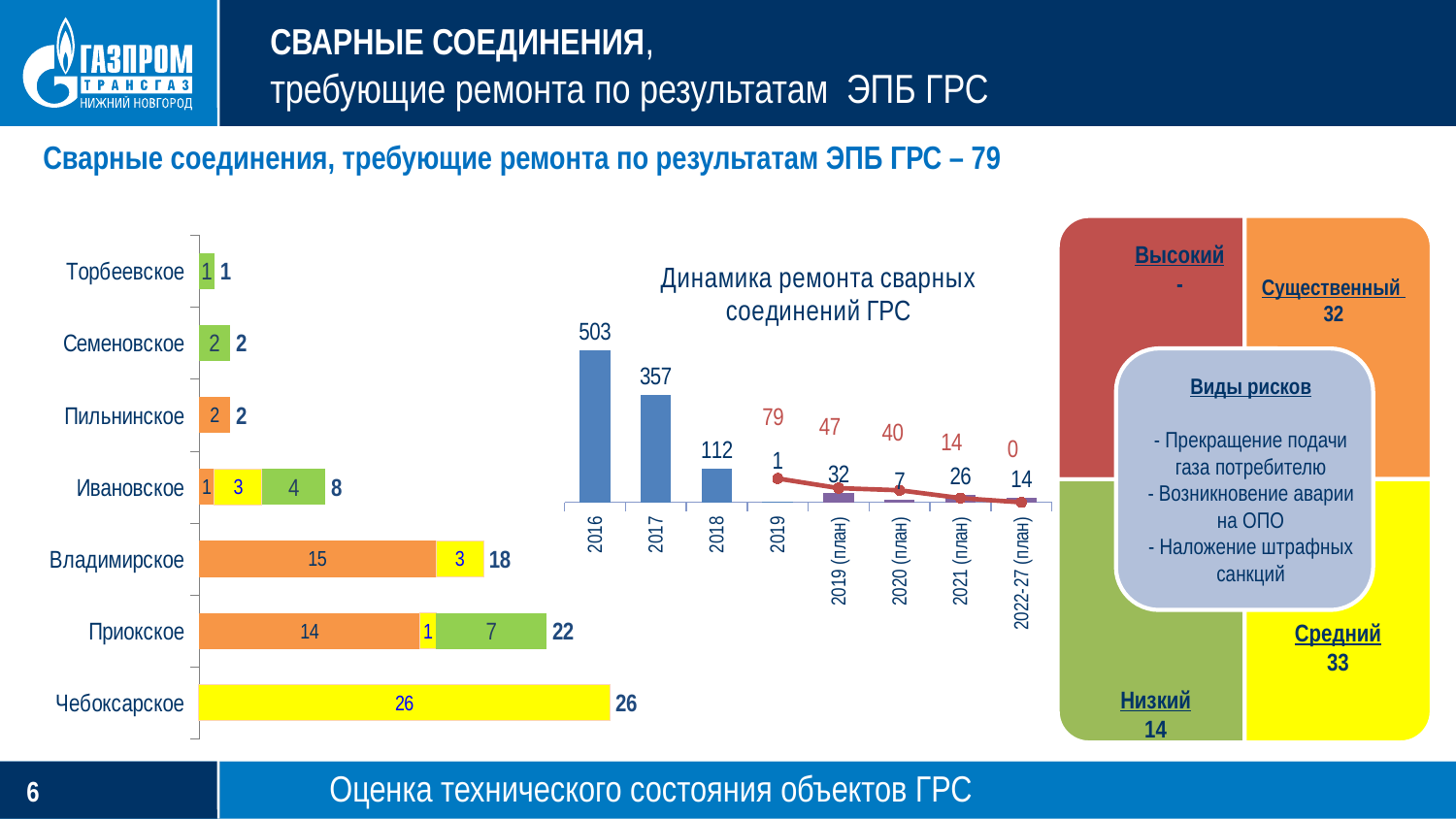
In the chart 'Динамика ремонта сварных соединений ГРС', do the bar values rise or fall from 2016 to 2019? fall In the left chart, what is the value of the yellow segment for Ивановское? 3 What kind of chart is the chart on the left side of the slide? bar chart In the chart 'Динамика ремонта сварных соединений ГРС', which year has the highest bar? 2016 In the left chart, which category has the highest total? Чебоксарское In the chart 'Динамика ремонта сварных соединений ГРС', what is the bar value for 2018? 112 In the left chart, which has a larger total: Владимирское or Ивановское? Владимирское In the chart 'Динамика ремонта сварных соединений ГРС', what is the difference between the bar values for 2016 and 2017? 146 In the left chart, what is the total value shown for Приокское? 22 In the left chart, what is the difference between the totals for Чебоксарское and Владимирское? 8 How many categories are shown in the left chart? 7 In the chart 'Динамика ремонта сварных соединений ГРС', what is the bar value for 2016? 503